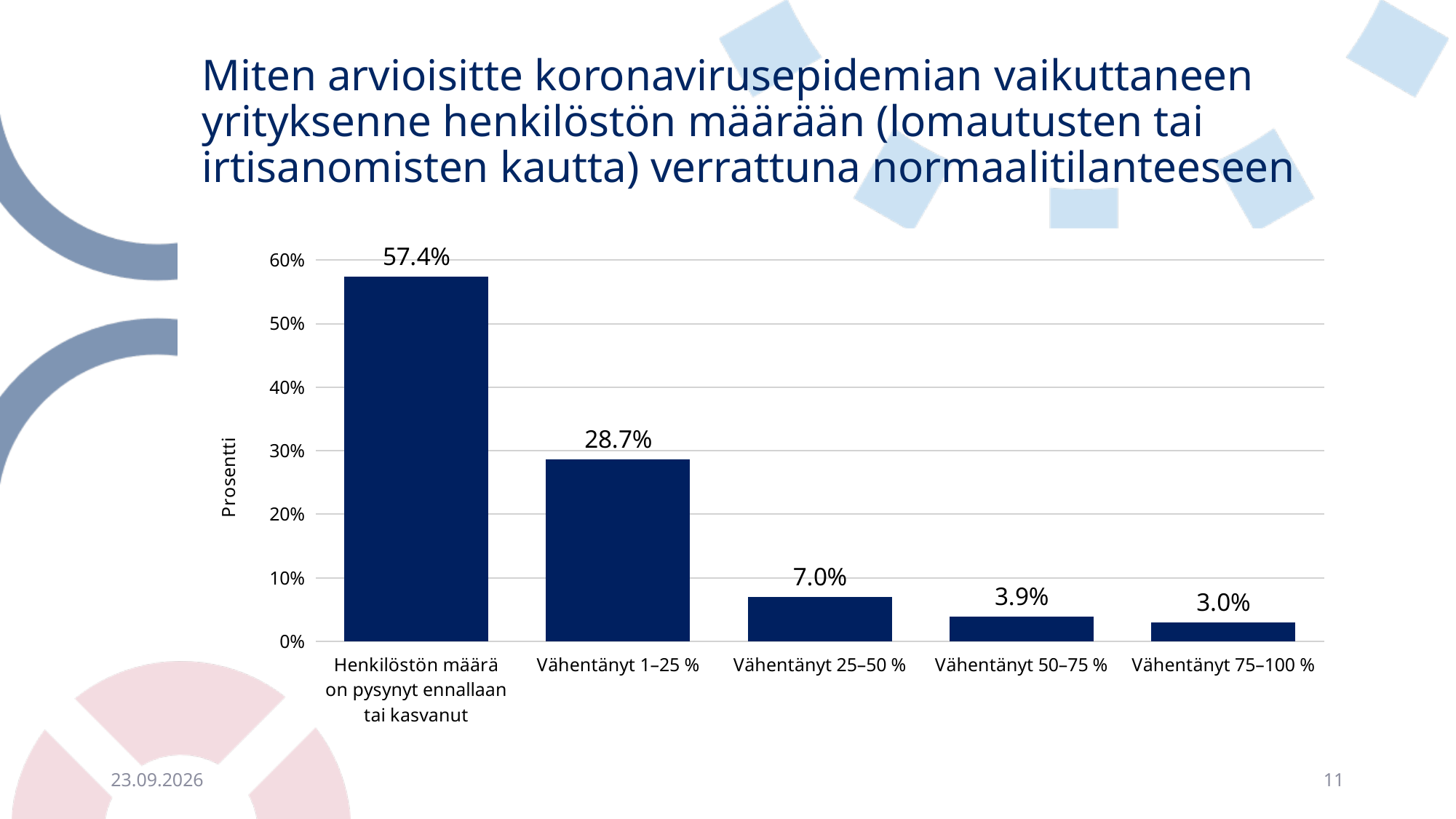
What is the difference between the values for "Henkilöstön määrä on pysynyt ennallaan tai kasvanut" and "Vähentänyt 1–25 %"? 28.7% What is the value for "Vähentänyt 1–25 %"? 28.7% What is the value for "Henkilöstön määrä on pysynyt ennallaan tai kasvanut"? 57.4% Which is larger, the value for "Vähentänyt 25–50 %" or "Vähentänyt 75–100 %"? Vähentänyt 25–50 % What is the value for "Vähentänyt 50–75 %"? 3.9% Which category has the highest value? Henkilöstön määrä on pysynyt ennallaan tai kasvanut What is the label of the vertical axis? Prosentti What kind of chart is shown on the slide? Bar chart Which category has the lowest value? Vähentänyt 75–100 % How many categories are shown on the x axis? 5 What is the value for "Vähentänyt 75–100 %"? 3.0% What is the difference between the values for "Vähentänyt 25–50 %" and "Vähentänyt 50–75 %"? 3.1%